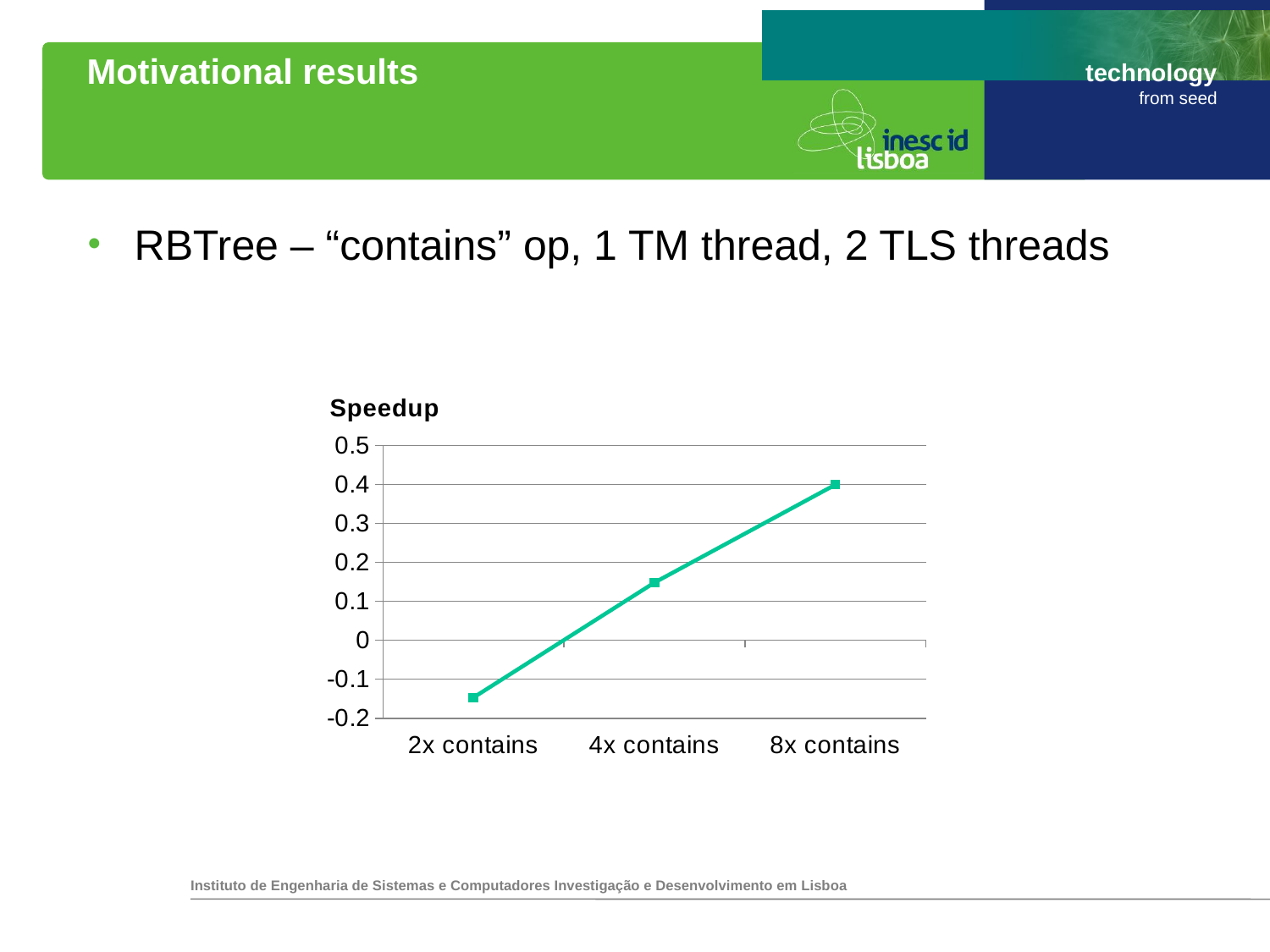
Is the speedup for 2x contains greater or less than -0.1? less What is the title of the chart? Speedup Is the speedup for 4x contains greater or less than 0.2? less Which has a larger speedup, 4x contains or 8x contains? 8x contains Which category has the highest speedup? 8x contains Do the speedup values rise or fall from 2x contains to 8x contains? rise Is the speedup for 2x contains greater or less than 0? less What kind of chart is shown on the slide? line chart How many data points are plotted on the chart? 3 Which category has the lowest speedup? 2x contains